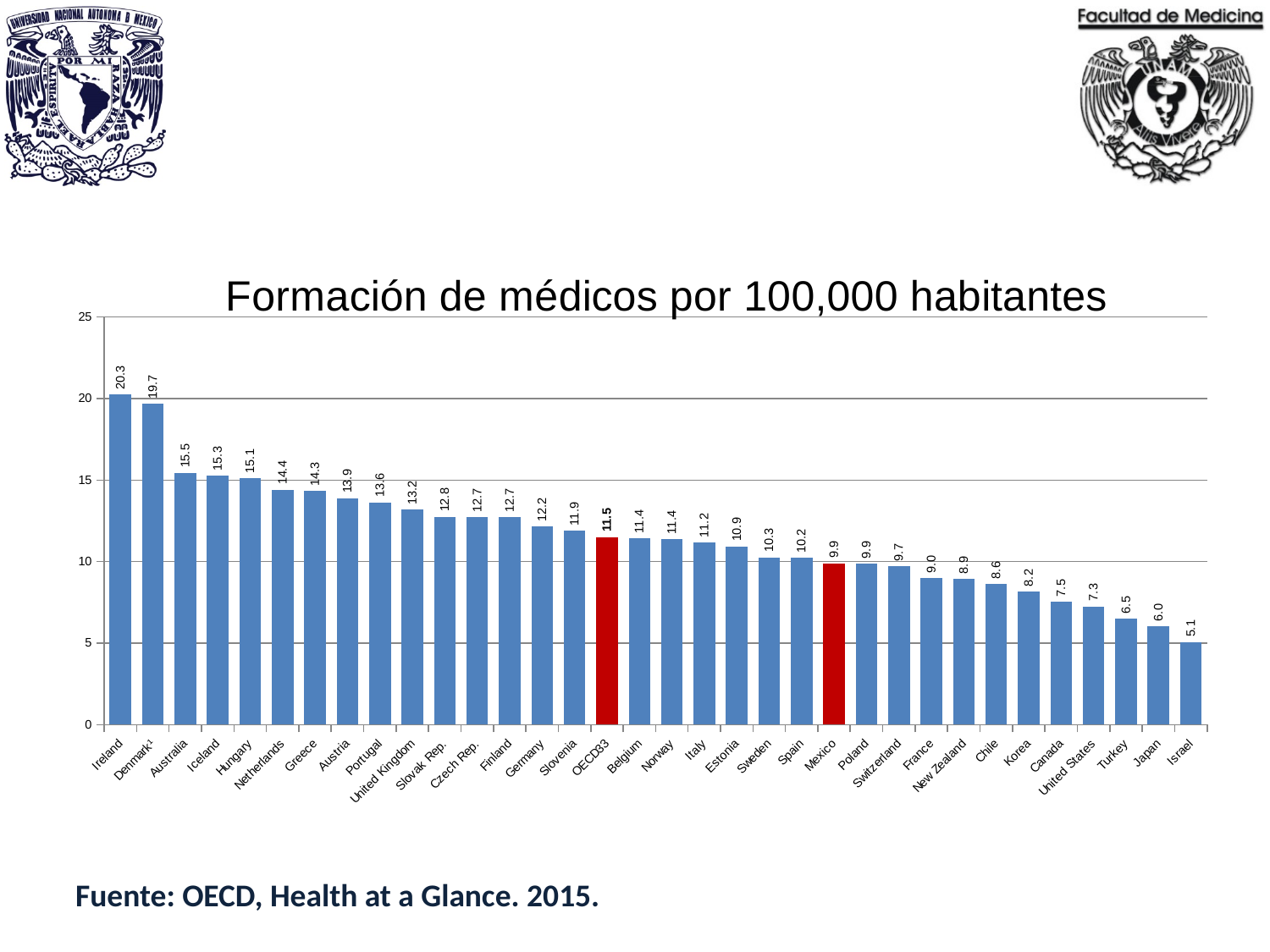
Which two bars are highlighted in red? OECD33 and Mexico What is the difference between the values for Ireland and Mexico? 10.4 How many bars are shown in the chart? 34 What is the difference between the OECD33 value and the value for Mexico? 1.6 Which country has the highest value? Ireland What is the value for OECD33? 11.5 Which country has the lowest value? Israel What is the value for Ireland? 20.3 What is the value for Mexico? 9.9 Is the value for Japan greater or less than 10? less What kind of chart is shown on the slide? bar chart Which has a larger value, Germany or Slovenia? Germany